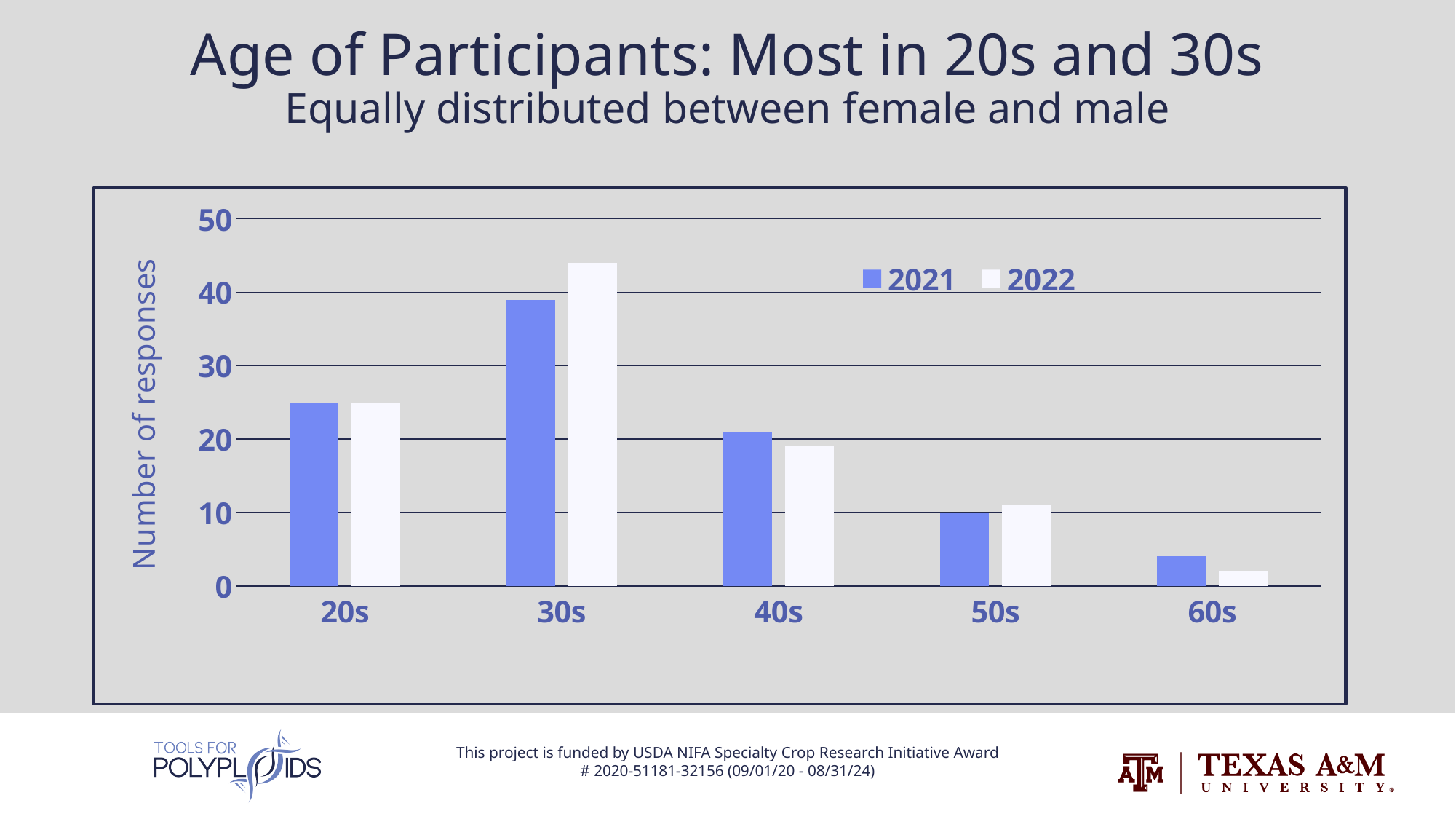
Which age group has the highest number of responses for 2022? 30s For the 30s age group, which year has more responses, 2021 or 2022? 2022 For the 60s age group, which year has more responses, 2021 or 2022? 2021 How many series does the legend list? 2 Do the 2022 values rise or fall from the 30s age group to the 60s age group? fall How many age categories are shown on the x axis? 5 Which age group has the lowest number of responses for 2022? 60s Which age group has the highest number of responses for 2021? 30s Is the 2021 value for the 20s age group greater or less than 20? greater What kind of chart is shown on the slide? bar chart Is the 2022 value for the 30s age group greater or less than 40? greater